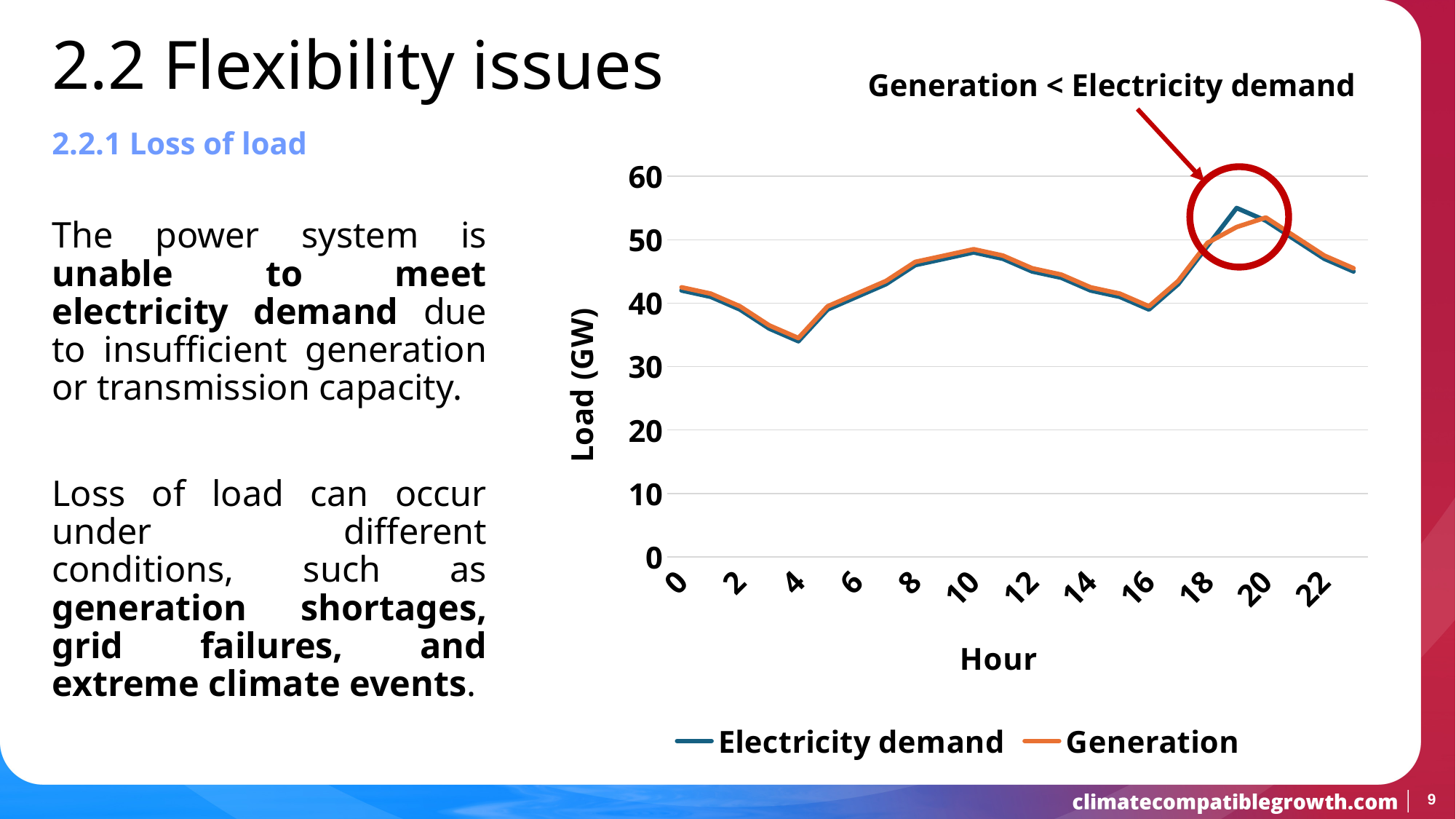
Is the Electricity demand value at hour 22 greater or less than 50? less What is the title of the chart's vertical axis? Load (GW) How many series does the chart legend list? 2 What kind of chart is shown on the slide? line chart Is the Electricity demand value at hour 20 greater or less than 50? greater Is the Electricity demand value at hour 4 greater or less than 40? less Between hour 4 and hour 10, does Electricity demand rise or fall? rise What are the two series named in the chart legend? Electricity demand and Generation At which hour does Electricity demand reach its lowest value? 4